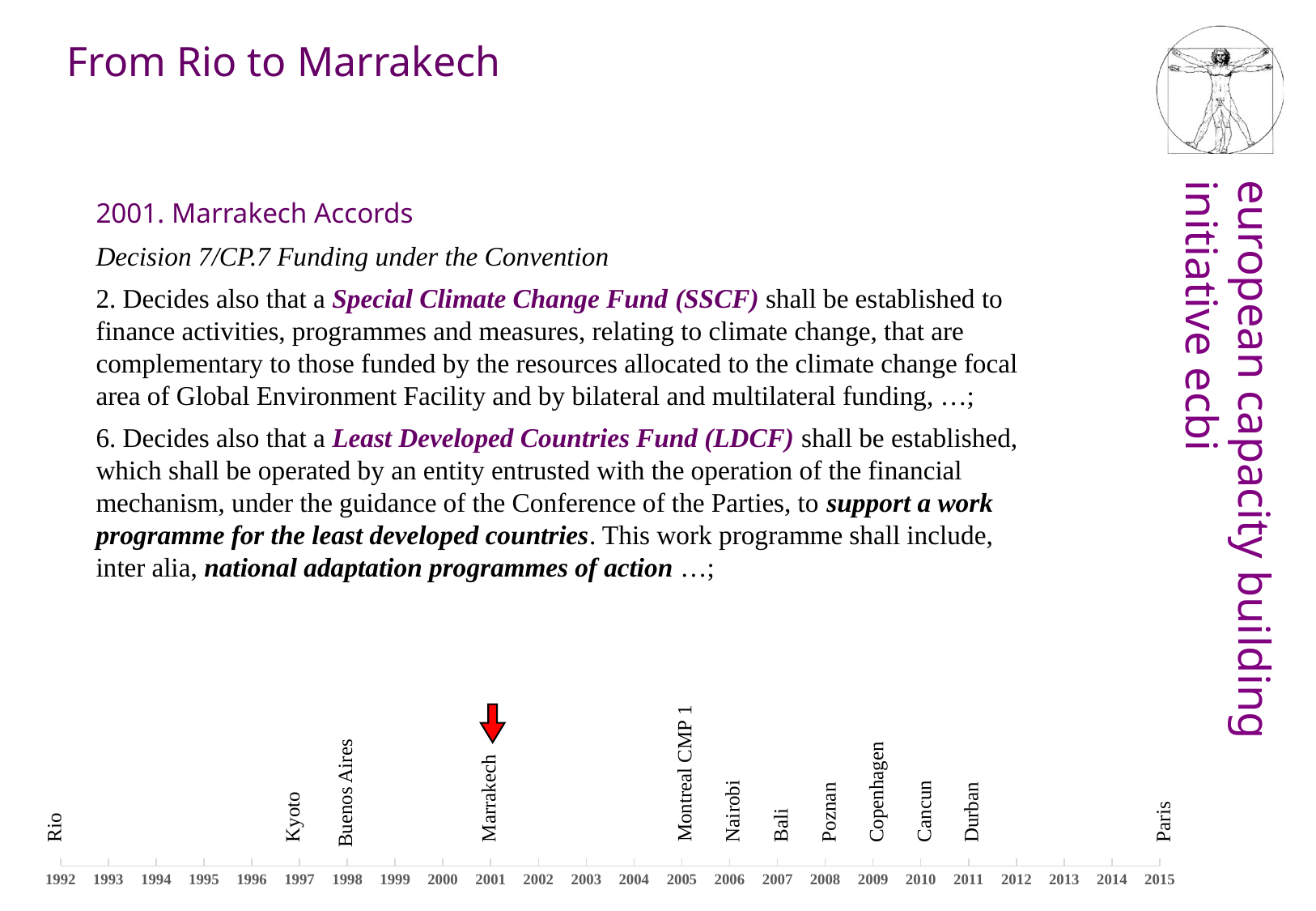
How many labelled events are shown on the timeline at the bottom of the slide? 12 On the timeline at the bottom of the slide, which year is Kyoto placed at? 1997 How many year ticks are labelled on the timeline axis at the bottom of the slide? 24 On the timeline at the bottom of the slide, which event is placed at 2005? Montreal CMP 1 On the timeline at the bottom of the slide, which event is placed at 1992? Rio What kind of chart is shown at the bottom of the slide? timeline On the timeline at the bottom of the slide, which event is placed at 2009? Copenhagen On the timeline at the bottom of the slide, which event is placed at 2015? Paris On the timeline at the bottom of the slide, which year is Buenos Aires placed at? 1998 On the timeline at the bottom of the slide, which year is Marrakech placed at? 2001 Which event does the red arrow on the timeline point to? Marrakech On the timeline at the bottom of the slide, which year is Durban placed at? 2011